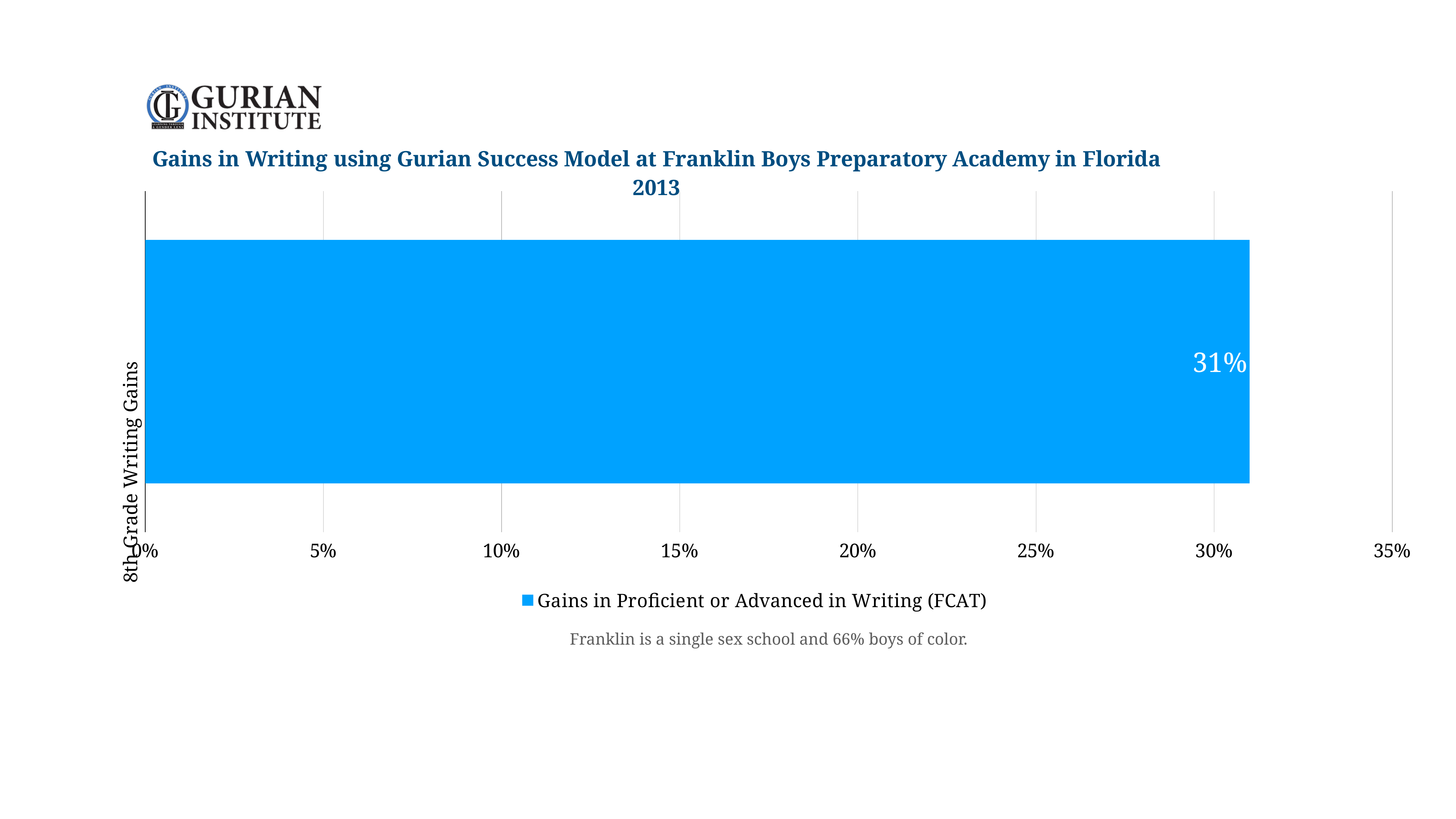
What is the value shown for 8th Grade Writing Gains? 31% How many series does the legend list? 1 What kind of chart is shown on the slide? bar chart Is the value for 8th Grade Writing Gains greater or less than 30%? greater What is the title of the chart? Gains in Writing using Gurian Success Model at Franklin Boys Preparatory Academy in Florida 2013 How many bars are plotted in the chart? 1 Is the value for 8th Grade Writing Gains greater or less than 35%? less What is the series name shown in the legend? Gains in Proficient or Advanced in Writing (FCAT) What is the highest value shown on the x axis? 35%